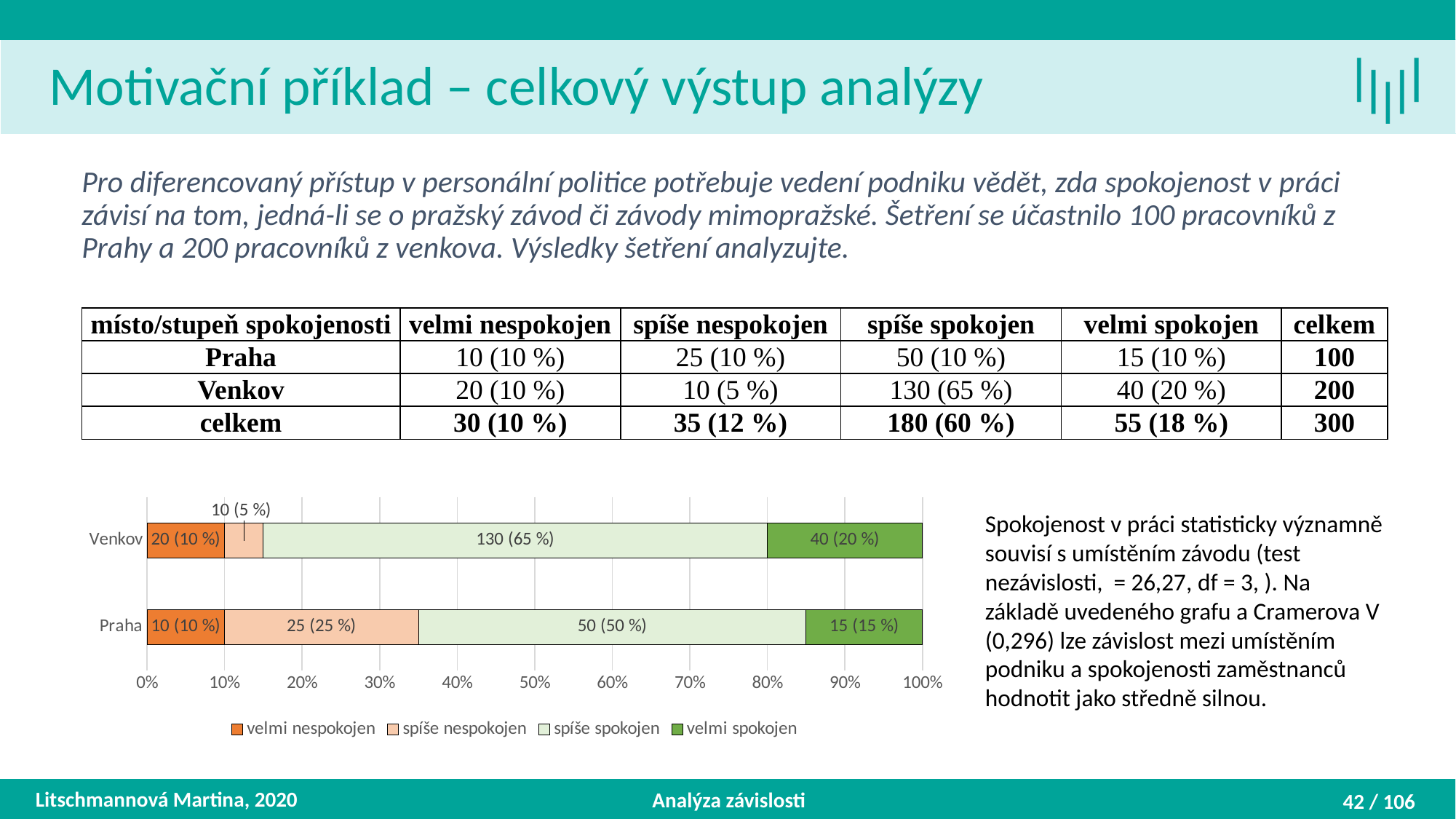
What kind of chart is shown on the slide? stacked bar chart Which segment of the Venkov bar is the smallest? spíše nespokojen How many categories (bars) are plotted in the chart? 2 Which is larger: the 'velmi spokojen' share for Venkov or for Praha? Venkov What is the data label for 'velmi spokojen' in the Venkov bar? 40 (20 %) What is the difference in count between 'spíše spokojen' for Venkov and 'spíše spokojen' for Praha? 80 How many series does the chart legend list? 4 Which legend entry is shown in the darkest orange colour? velmi nespokojen Which segment of the Praha bar is the largest? spíše spokojen What is the data label for 'velmi nespokojen' in the Praha bar? 10 (10 %) What is the data label for 'spíše nespokojen' in the Praha bar? 25 (25 %) What is the data label for 'spíše spokojen' in the Venkov bar? 130 (65 %)